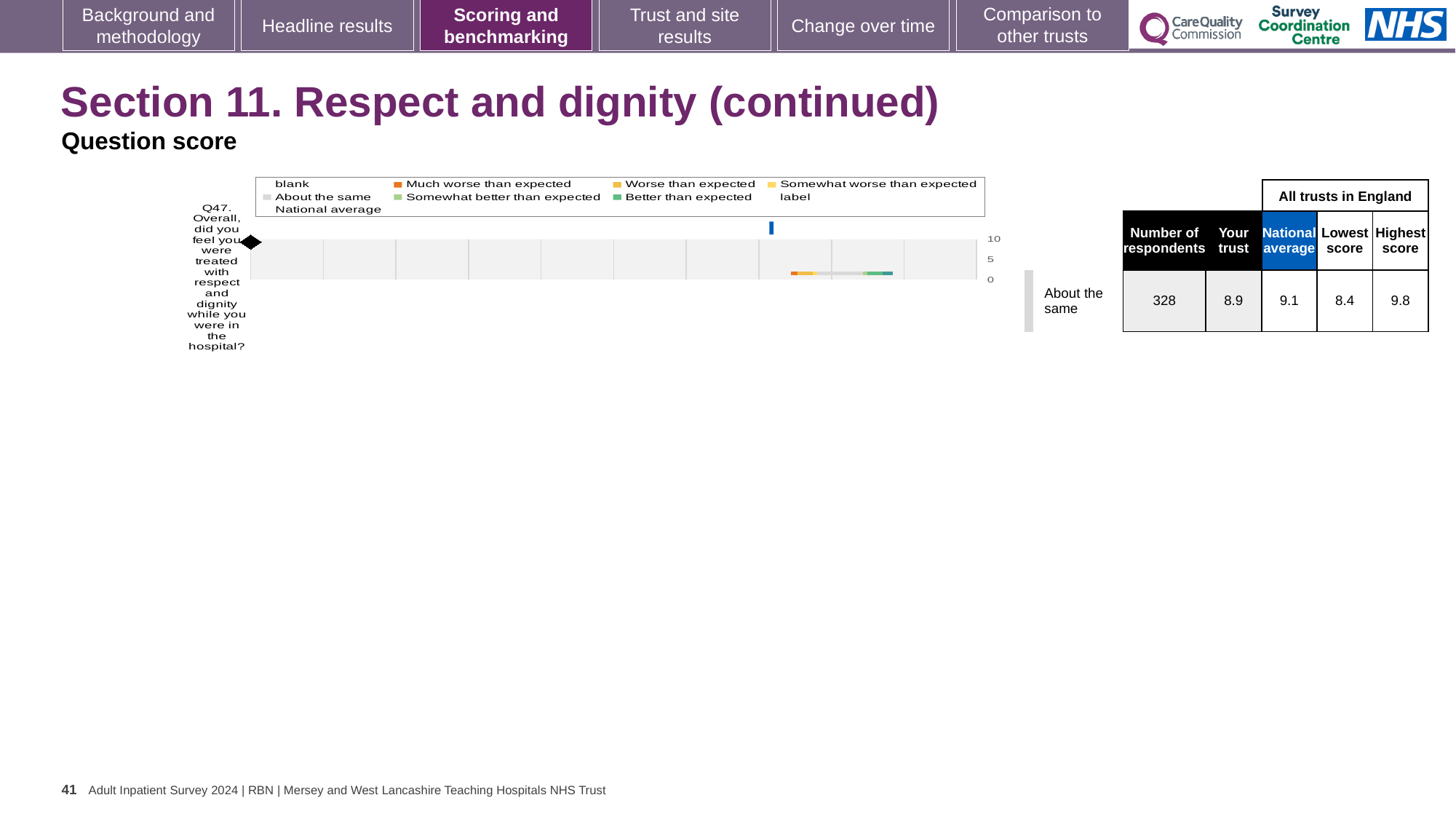
What is the 'Your trust' score for Q47 shown in the table beside the chart? 8.9 What is the highest tick value shown on the chart's score axis? 10 Which is larger for Q47, the 'Your trust' score or the national average? National average Which question number is plotted on the chart? Q47 What is the number of respondents for Q47 shown in the table beside the chart? 328 What is the national average score for Q47 shown in the table beside the chart? 9.1 How many entries does the chart legend list? 9 Is the national average marker for Q47 on the chart greater or less than 5? greater How many questions (categories) are plotted on the chart? 1 What is the highest score among all trusts in England for Q47 shown in the table? 9.8 What kind of chart is shown on the slide? bar chart What is the difference between the highest score (9.8) and the lowest score (8.4) for Q47 in the table? 1.4